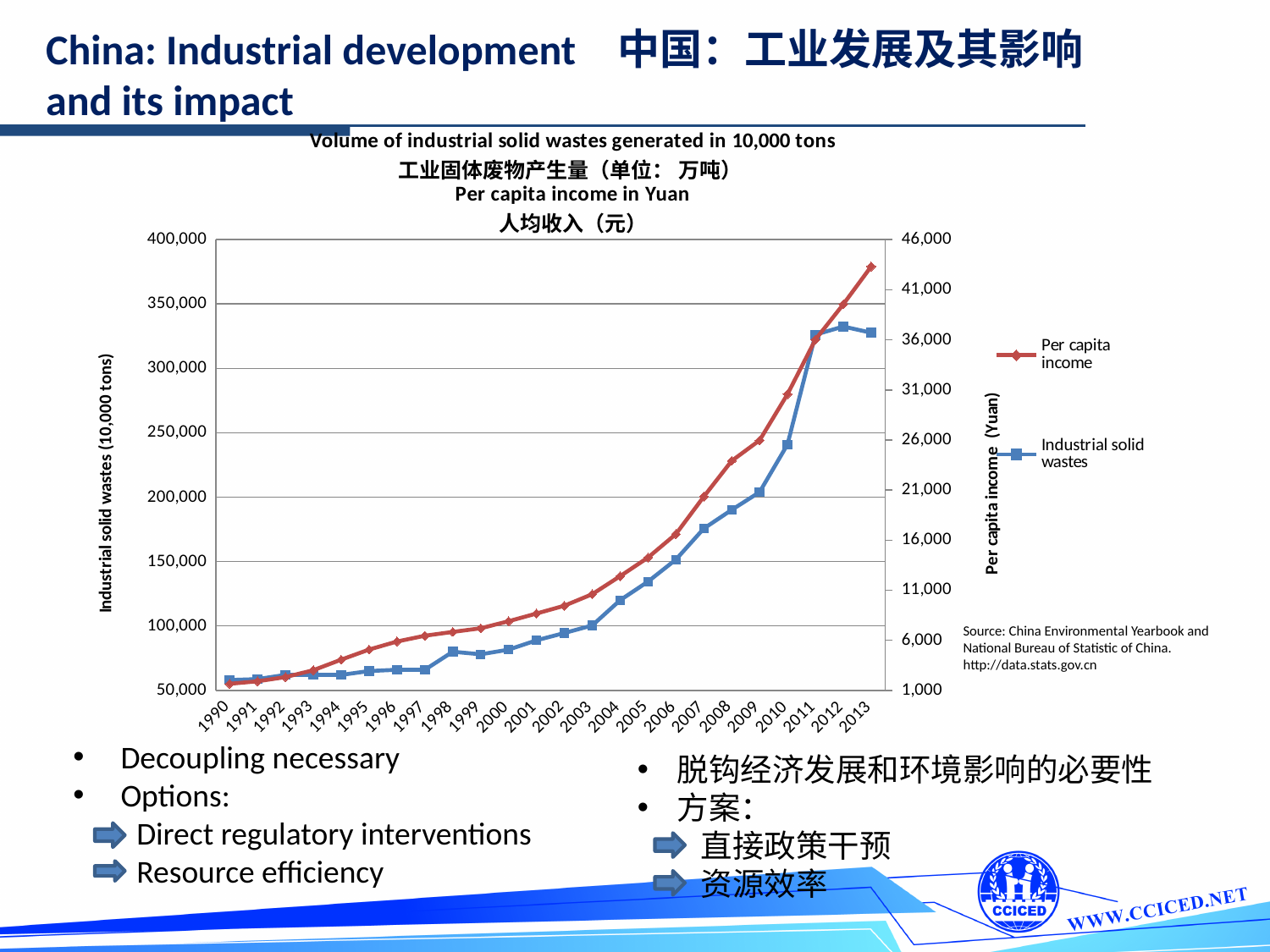
Is the value for industrial solid wastes in 1990 greater or less than 100,000? less Is the value for industrial solid wastes in 2005 greater or less than 150,000? less How many series does the legend list? 2 What kind of chart is shown on the slide? line chart Is the value for industrial solid wastes in 2012 greater or less than 300,000? greater What is the title of the right-hand vertical axis? Per capita income (Yuan) Which colour is used for the Industrial solid wastes series? blue Which is larger, the industrial solid wastes value in 2011 or in 2009? 2011 Does per capita income generally rise or fall from 1990 to 2013? rise Which year has the highest per capita income? 2013 How many years are plotted along the x axis? 24